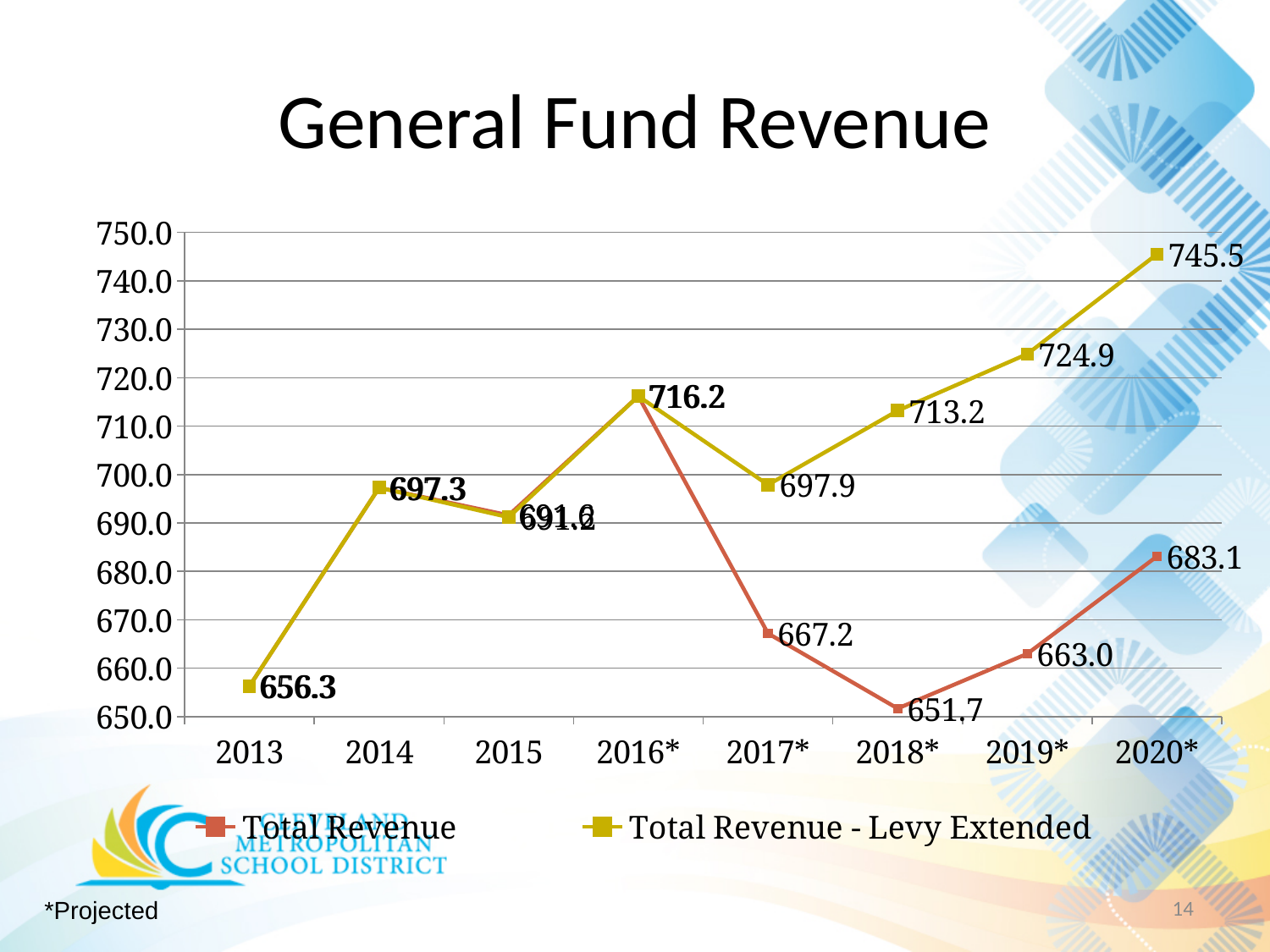
In 2019*, which series has the larger value, Total Revenue or Total Revenue - Levy Extended? Total Revenue - Levy Extended In which year is Total Revenue - Levy Extended highest? 2020* How many years are shown on the x axis? 8 Does Total Revenue - Levy Extended rise or fall from 2017* to 2020*? rise What is the title of the chart? General Fund Revenue What kind of chart is shown on the slide? line chart What is the Total Revenue - Levy Extended value for 2020*? 745.5 In which year is Total Revenue lowest? 2018* What is the Total Revenue value for 2017*? 667.2 What is the Total Revenue value for 2018*? 651.7 How many series does the legend list? 2 What is the difference between Total Revenue - Levy Extended and Total Revenue in 2020*? 62.4